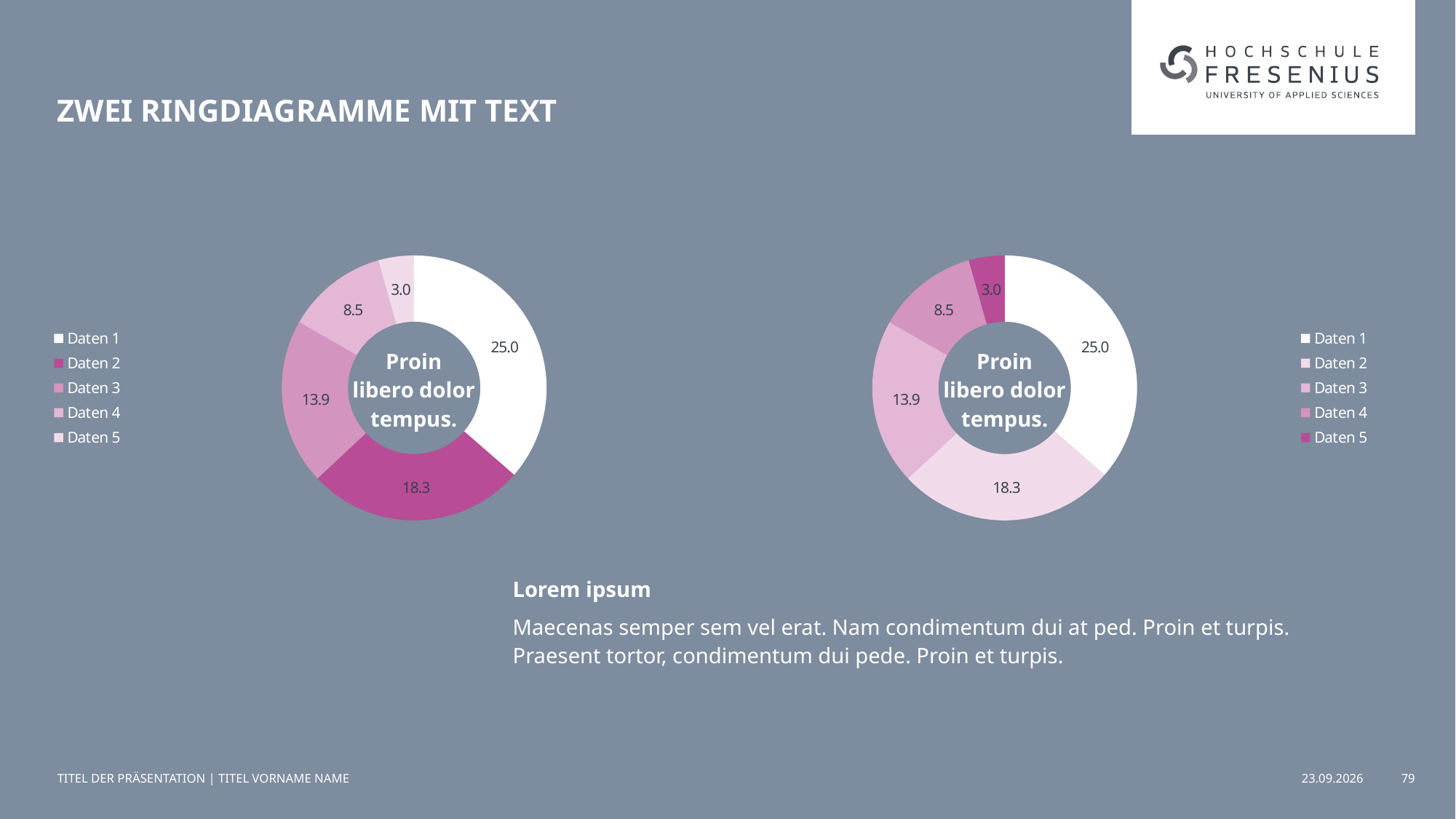
In the right chart, what is the difference between the values for Daten 3 and Daten 4? 5.4 How many entries does the legend of the right chart list? 5 In the right chart, which is larger, the value for Daten 2 or the value for Daten 3? Daten 2 In the left chart, what is the difference between the values for Daten 1 and Daten 2? 6.7 In the left chart, what is the value for Daten 1? 25.0 What kind of chart is the left chart? Doughnut (ring) chart In the right chart, which category has the highest value? Daten 1 In the right chart, what is the value for Daten 4? 8.5 In the left chart, what is the value for Daten 3? 13.9 In the left chart, which category has the lowest value? Daten 5 How many categories does the left chart show? 5 What text is shown in the centre of the right chart? Proin libero dolor tempus.